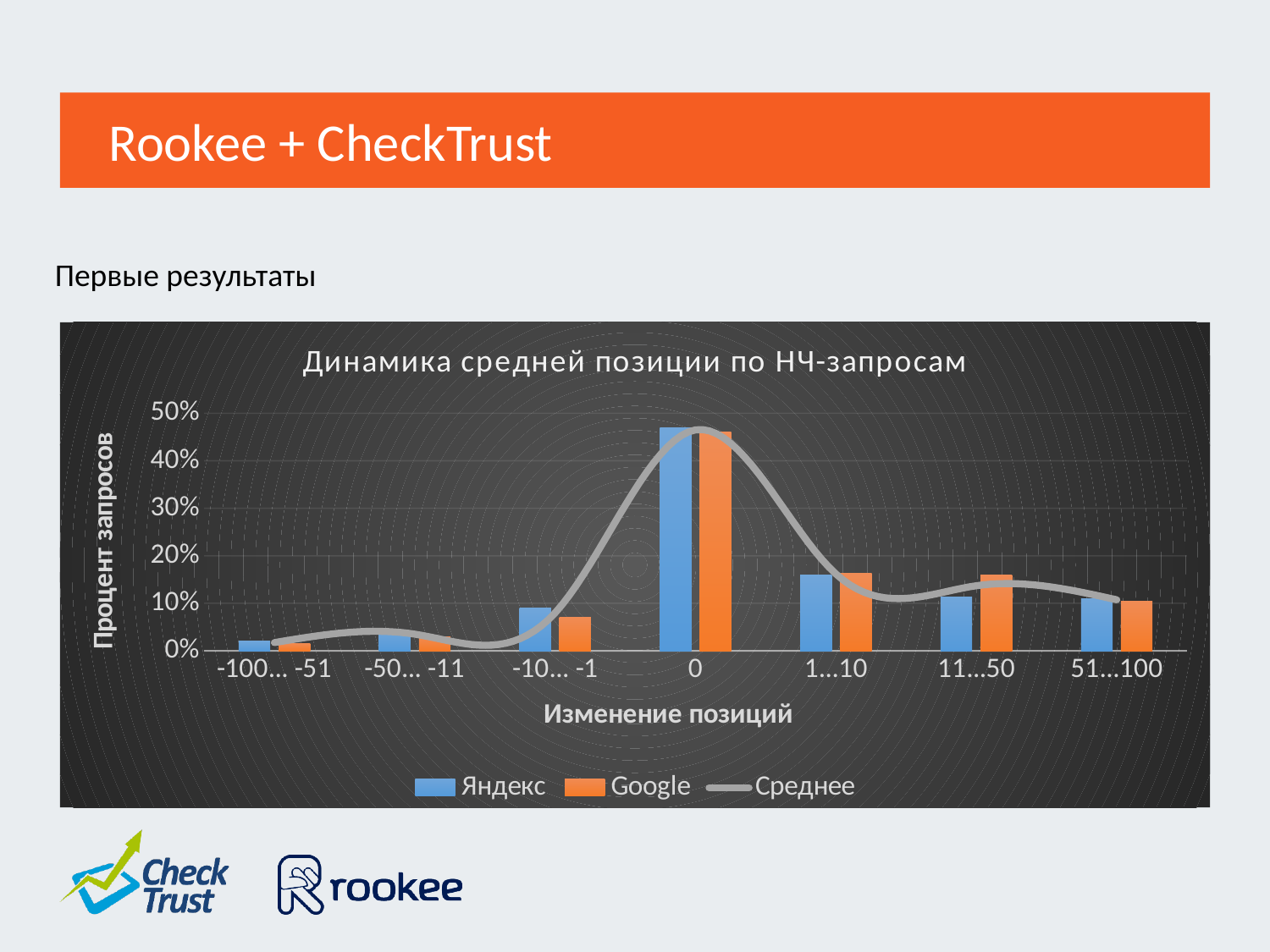
Is the value for Яндекс in the -10…-1 category greater or less than 10%? less Is the value for Google in the 11…50 category greater or less than 10%? greater In the 11…50 category, which series has the larger value, Яндекс or Google? Google Which category has the highest value for Яндекс? 0 In the -10…-1 category, which series has the larger value, Яндекс or Google? Яндекс Is the value for Яндекс in the 0 category greater or less than 40%? greater What kind of chart is shown on the slide? Bar chart with a line What is the label of the x axis of the chart? Изменение позиций How many series does the chart legend list? 3 How many categories are shown on the x axis of the chart? 7 Which category has the lowest value for Google? -100…-51 What is the title of the chart? Динамика средней позиции по НЧ-запросам